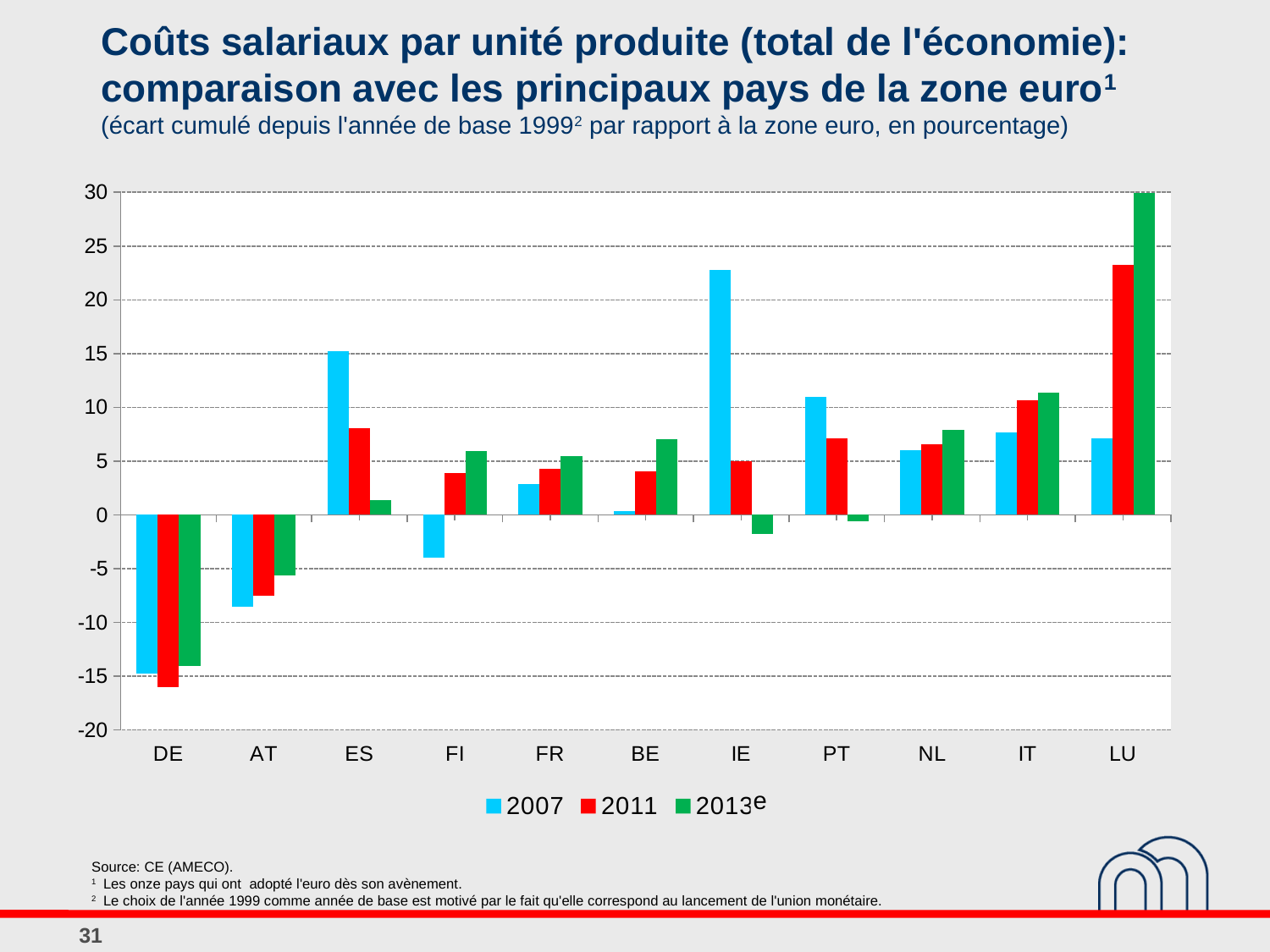
How many countries are shown on the x axis of the chart? 11 What are the three series listed in the legend? 2007, 2011, 2013e Which country has the lowest value for 2011? DE How many series does the legend list? 3 Which country has the highest value for 2013e? LU For ES, which is larger: the 2007 value or the 2013e value? 2007 For LU, do the values rise or fall from 2007 to 2013e? rise Is the 2011 value for DE greater or less than -10? less What kind of chart is shown on the slide? bar chart Is the 2013e value for LU greater or less than 25? greater Which country has the highest value for 2007? IE Is the 2007 value for IE greater or less than 20? greater